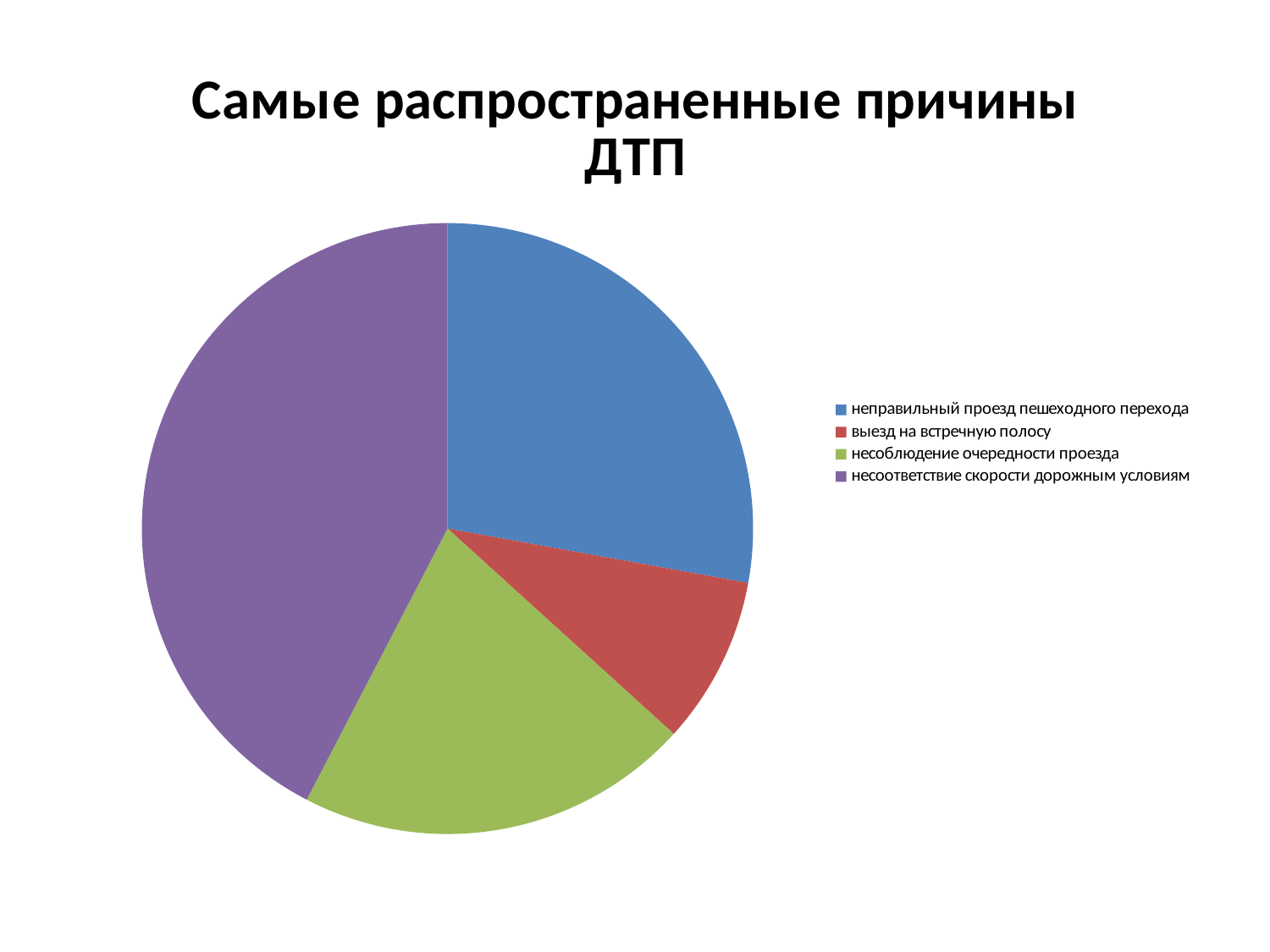
How many slices does the pie chart have? 4 What kind of chart is shown on the slide? pie chart How many entries does the legend list? 4 What is the title of the chart? Самые распространенные причины ДТП Which slice is larger: 'неправильный проезд пешеходного перехода' or 'несоблюдение очередности проезда'? неправильный проезд пешеходного перехода Which cause has the largest slice of the pie? несоответствие скорости дорожным условиям Which slice is larger: 'несоответствие скорости дорожным условиям' or 'неправильный проезд пешеходного перехода'? несоответствие скорости дорожным условиям What colour is the slice for 'выезд на встречную полосу'? red Which cause has the smallest slice of the pie? выезд на встречную полосу Which slice is larger: 'выезд на встречную полосу' or 'несоблюдение очередности проезда'? несоблюдение очередности проезда